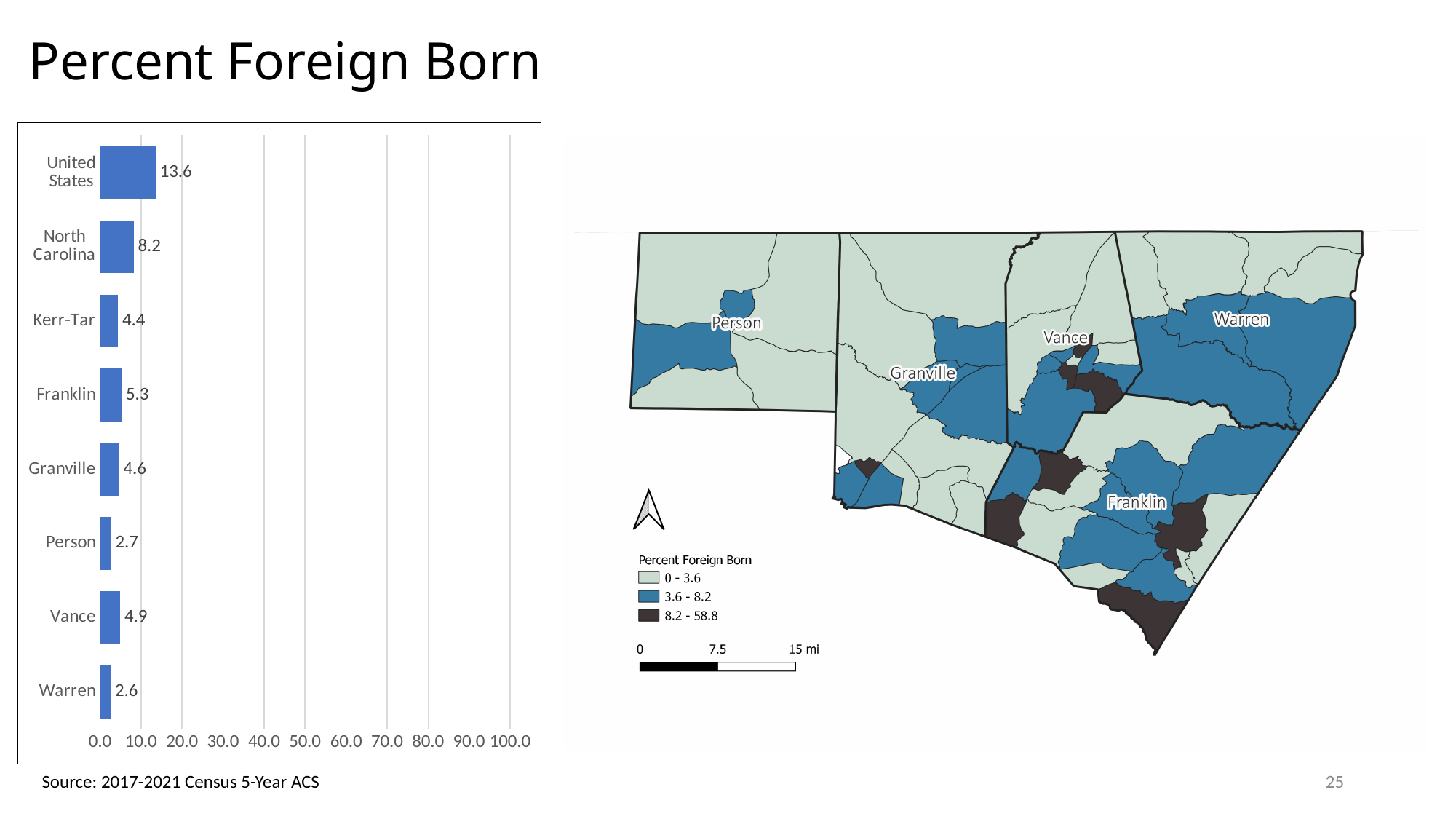
In the bar chart, which is larger, the value for Granville or the value for Kerr-Tar? Granville What is the title of the slide? Percent Foreign Born In the bar chart, what is the value for Franklin? 5.3 In the bar chart, what is the value for United States? 13.6 In the bar chart, which category has the lowest value? Warren What kind of chart is on the left side of the slide? bar chart In the bar chart, what is the difference between the values for Franklin and Person? 2.6 In the bar chart, which category has the highest value? United States In the bar chart, is the value for North Carolina greater or less than 10.0? less In the bar chart, what is the value for Vance? 4.9 In the bar chart, what is the difference between the values for United States and North Carolina? 5.4 How many categories are shown in the bar chart? 8